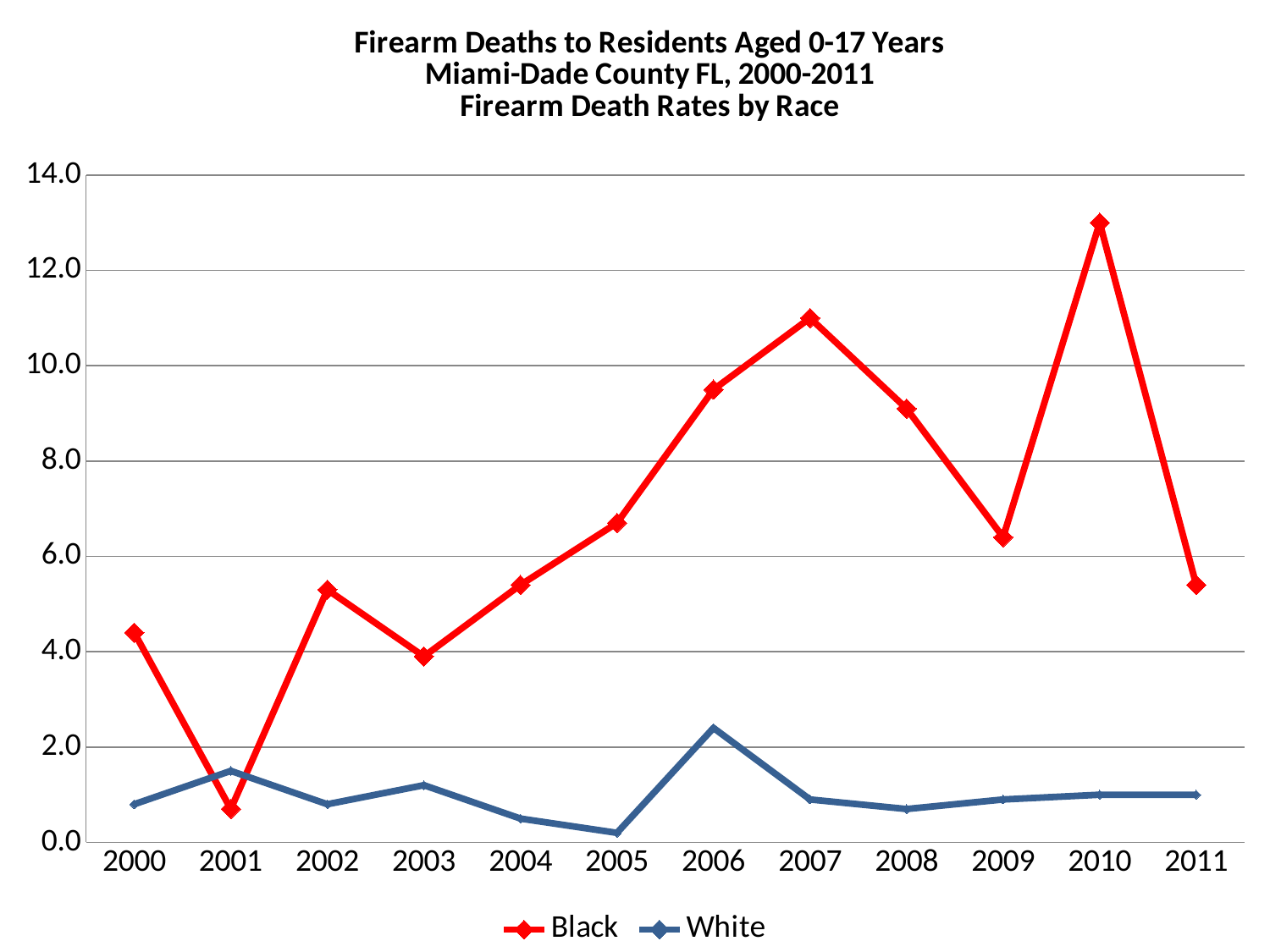
In which year is the firearm death rate for Black residents highest? 2010 How many series does the legend list? 2 Does the firearm death rate for Black residents rise or fall from 2003 to 2007? rise Is the value for White residents in 2006 greater or less than 2.0? greater Is the value for Black residents in 2010 greater or less than 12.0? greater In which year is the firearm death rate for White residents highest? 2006 In which year is the firearm death rate for Black residents lowest? 2001 In which year is the firearm death rate for White residents lowest? 2005 How many years are plotted along the x axis? 12 Is the value for Black residents in 2011 greater or less than 6.0? less Which series has the higher value in 2001, Black or White? White What kind of chart is shown on the slide? line chart